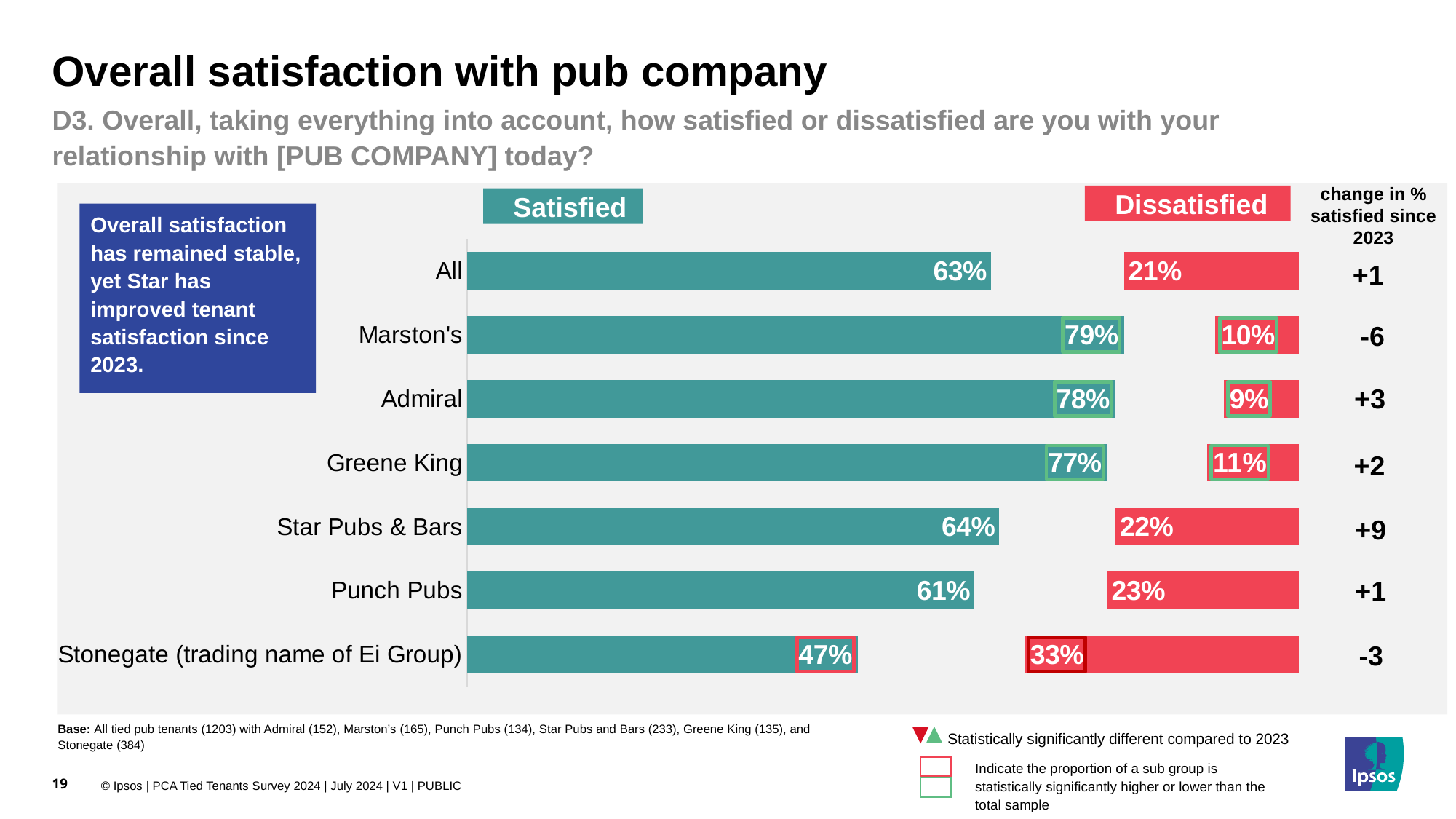
Which pub company has the highest satisfied percentage? Marston's Which is larger, the dissatisfied percentage for Punch Pubs or for Star Pubs & Bars? Punch Pubs What is the dissatisfied percentage for Stonegate (trading name of Ei Group)? 33% How many series does the chart show? 2 What is the change in % satisfied since 2023 for Star Pubs & Bars? +9 Which pub company has the lowest satisfied percentage? Stonegate (trading name of Ei Group) What colour are the Dissatisfied bars? Red How many categories (rows) are shown in the chart? 7 Which pub company has the lowest dissatisfied percentage? Admiral What kind of chart is shown on the slide? Bar chart What is the difference between the satisfied percentages for Marston's and Stonegate (trading name of Ei Group)? 32 percentage points What percentage of Marston's tenants are satisfied? 79%